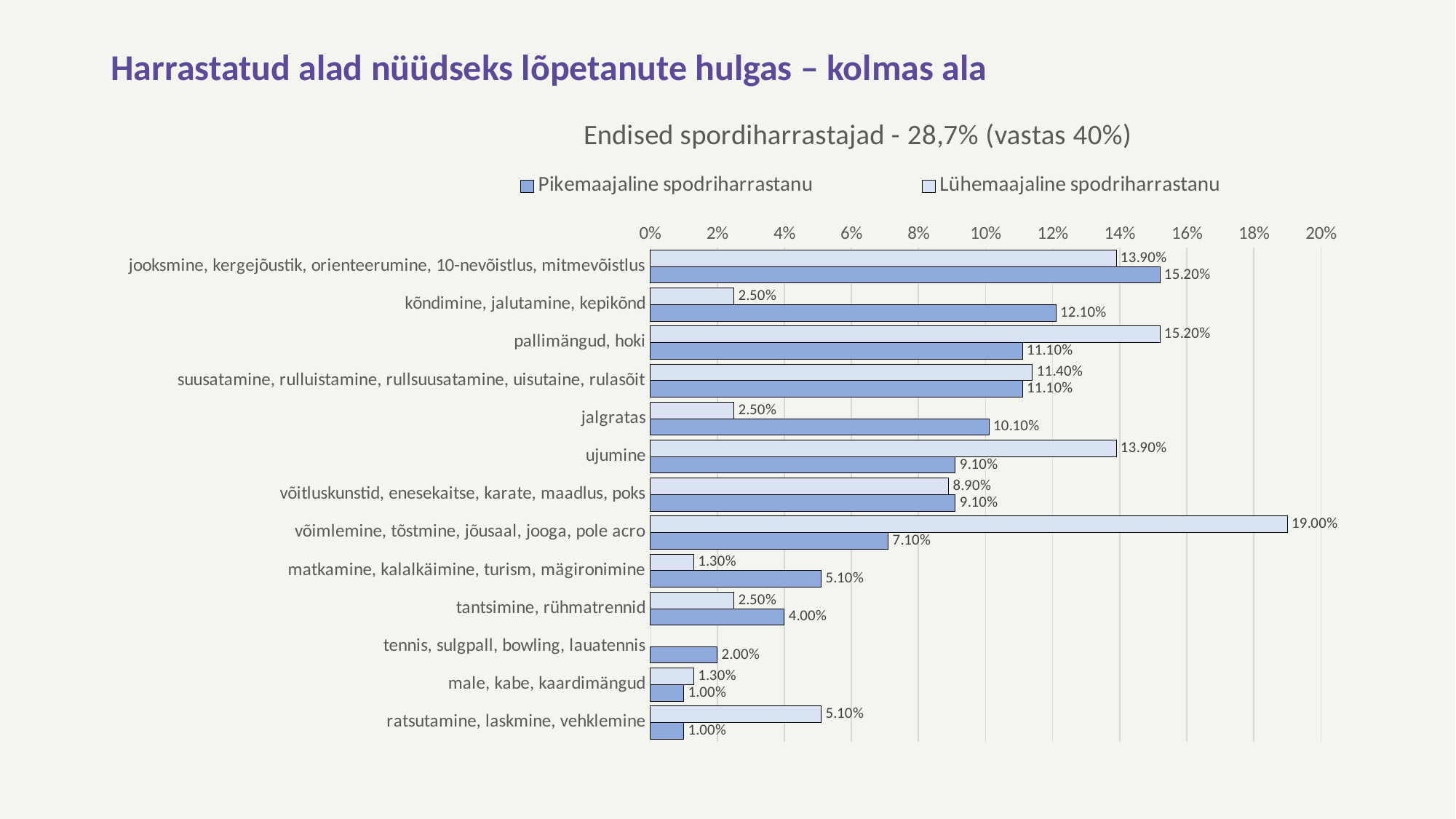
How many series does the legend list? 2 What type of chart is shown on the slide? bar chart Which category has the highest value for Pikemaajaline spodriharrastanu? jooksmine, kergejõustik, orienteerumine, 10-nevõistlus, mitmevõistlus What is the difference between the Lühemaajaline and Pikemaajaline values for 'võimlemine, tõstmine, jõusaal, jooga, pole acro'? 11.90% What is the difference between the Pikemaajaline values for 'jalgratas' and 'tantsimine, rühmatrennid'? 6.10% What is the value for Pikemaajaline spodriharrastanu in the category 'kõndimine, jalutamine, kepikõnd'? 12.10% What is the value for Pikemaajaline spodriharrastanu in the category 'jalgratas'? 10.10% For 'ujumine', which series has the larger value: Pikemaajaline spodriharrastanu or Lühemaajaline spodriharrastanu? Lühemaajaline spodriharrastanu What is the title of the chart? Endised spordiharrastajad - 28,7% (vastas 40%) What is the value for Lühemaajaline spodriharrastanu in the category 'võimlemine, tõstmine, jõusaal, jooga, pole acro'? 19.00% Which category has the highest value for Lühemaajaline spodriharrastanu? võimlemine, tõstmine, jõusaal, jooga, pole acro How many categories are shown on the chart? 13